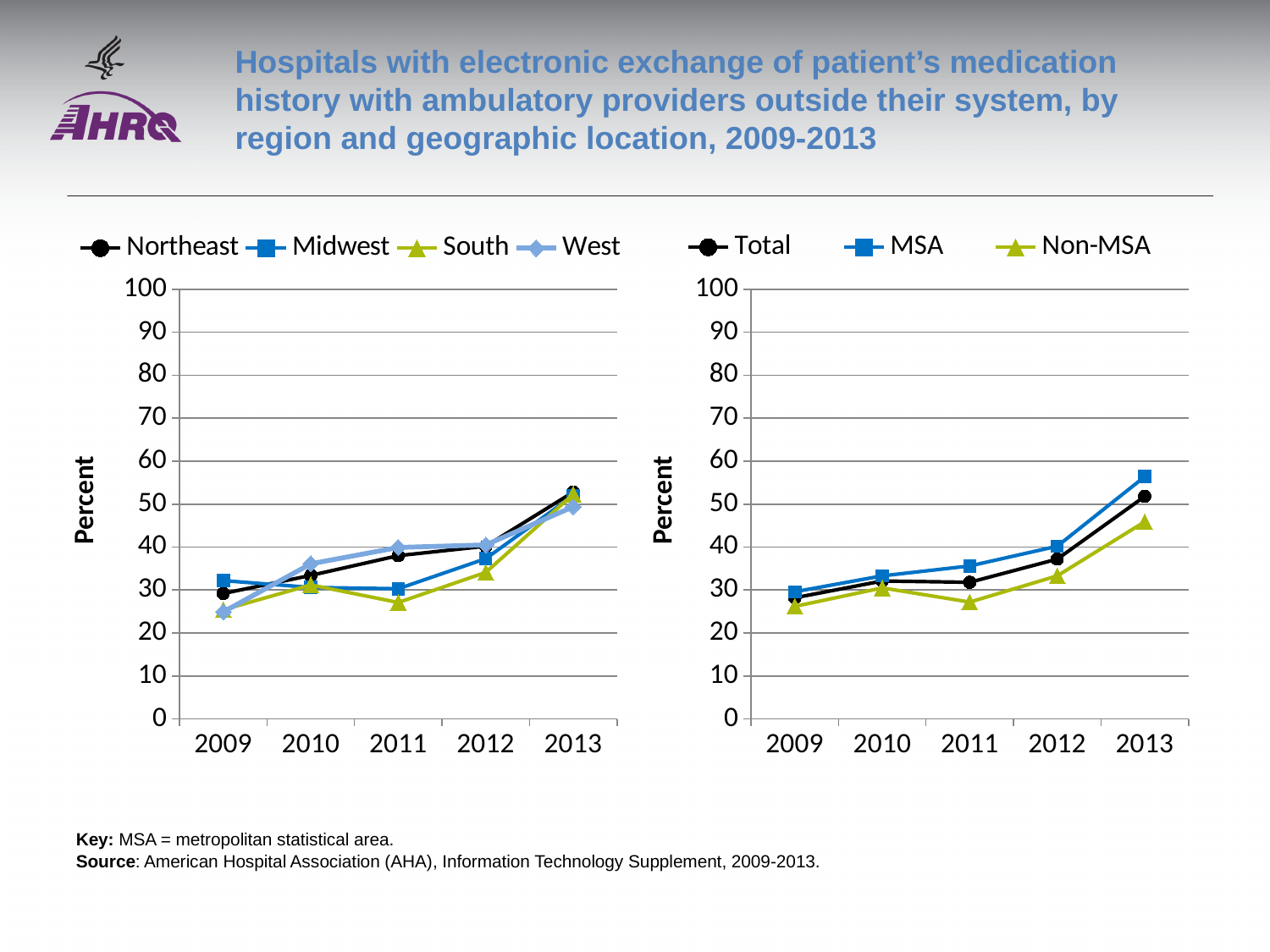
In the right chart, which series has the lowest value in 2013? Non-MSA How many series does the legend of the left chart list? 4 How many years are shown on the x axis of the right chart? 5 What kind of chart is the left chart (Northeast, Midwest, South, West)? line chart In the right chart, is the value for MSA in 2013 greater or less than 50? greater In the right chart, which series has the highest value in 2013? MSA In the left chart, is the value for South in 2011 greater or less than 30? less In the right chart, is the value for Non-MSA in 2013 greater or less than 50? less In the left chart, which series has the lowest value in 2011? South In the right chart, does the MSA series rise or fall from 2009 to 2013? rise How many series does the legend of the right chart list? 3 In the left chart, which is larger in 2010: West or South? West